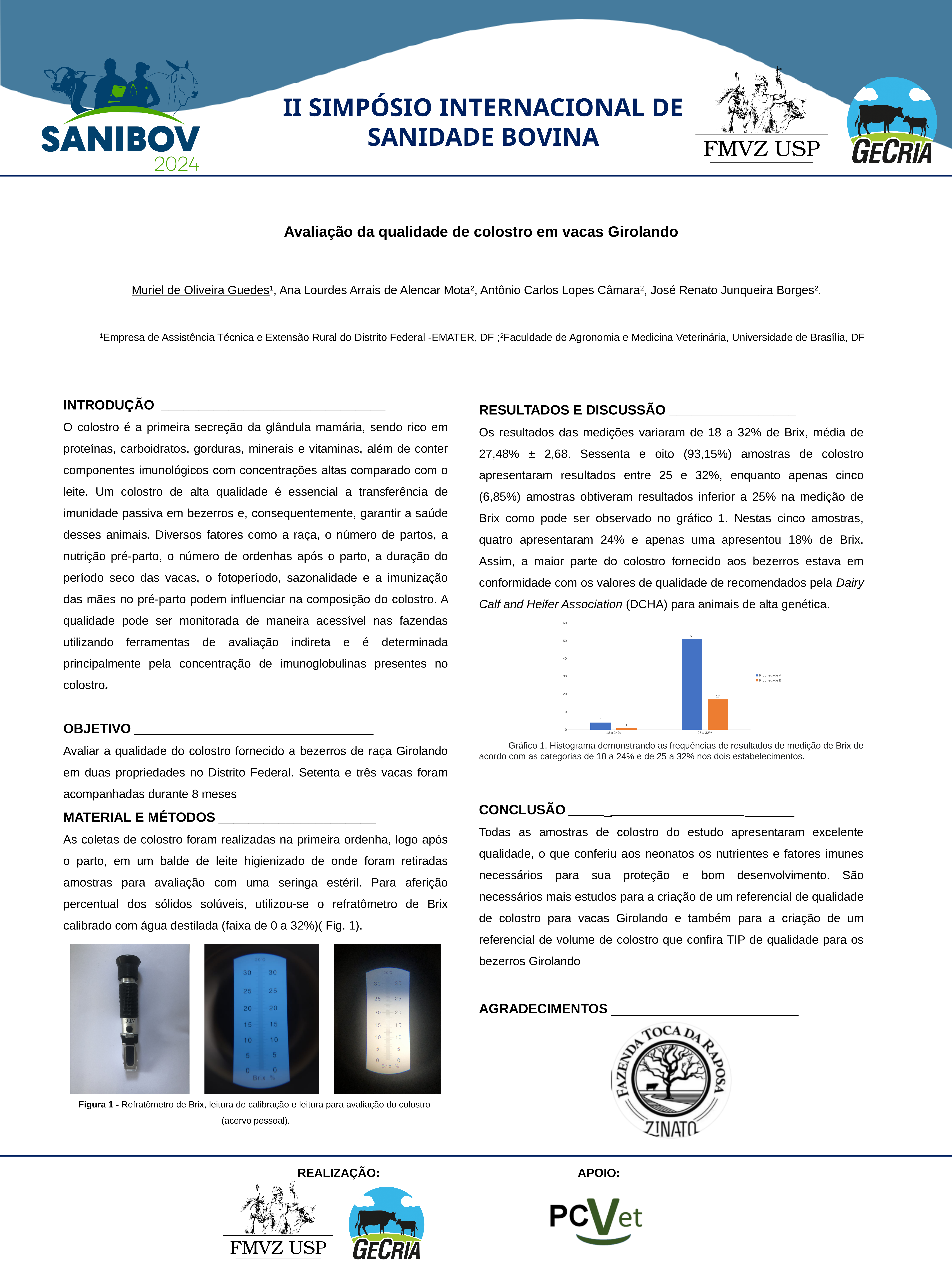
What is the value for Propriedade A in the 25 a 32% category? 51 What is the value for Propriedade B in the 18 a 24% category? 1 In the 18 a 24% category, which is larger, Propriedade A or Propriedade B? Propriedade A What is the value for Propriedade A in the 18 a 24% category? 4 Which category has the highest value for Propriedade A? 25 a 32% What are the two series named in the chart legend? Propriedade A and Propriedade B What is the value for Propriedade B in the 25 a 32% category? 17 What is the difference between Propriedade A and Propriedade B in the 25 a 32% category? 34 Is the value for Propriedade A in the 25 a 32% category greater or less than 40? greater What type of chart is shown on the slide? bar chart How many categories are shown on the x axis of the chart? 2 How many series does the chart legend list? 2